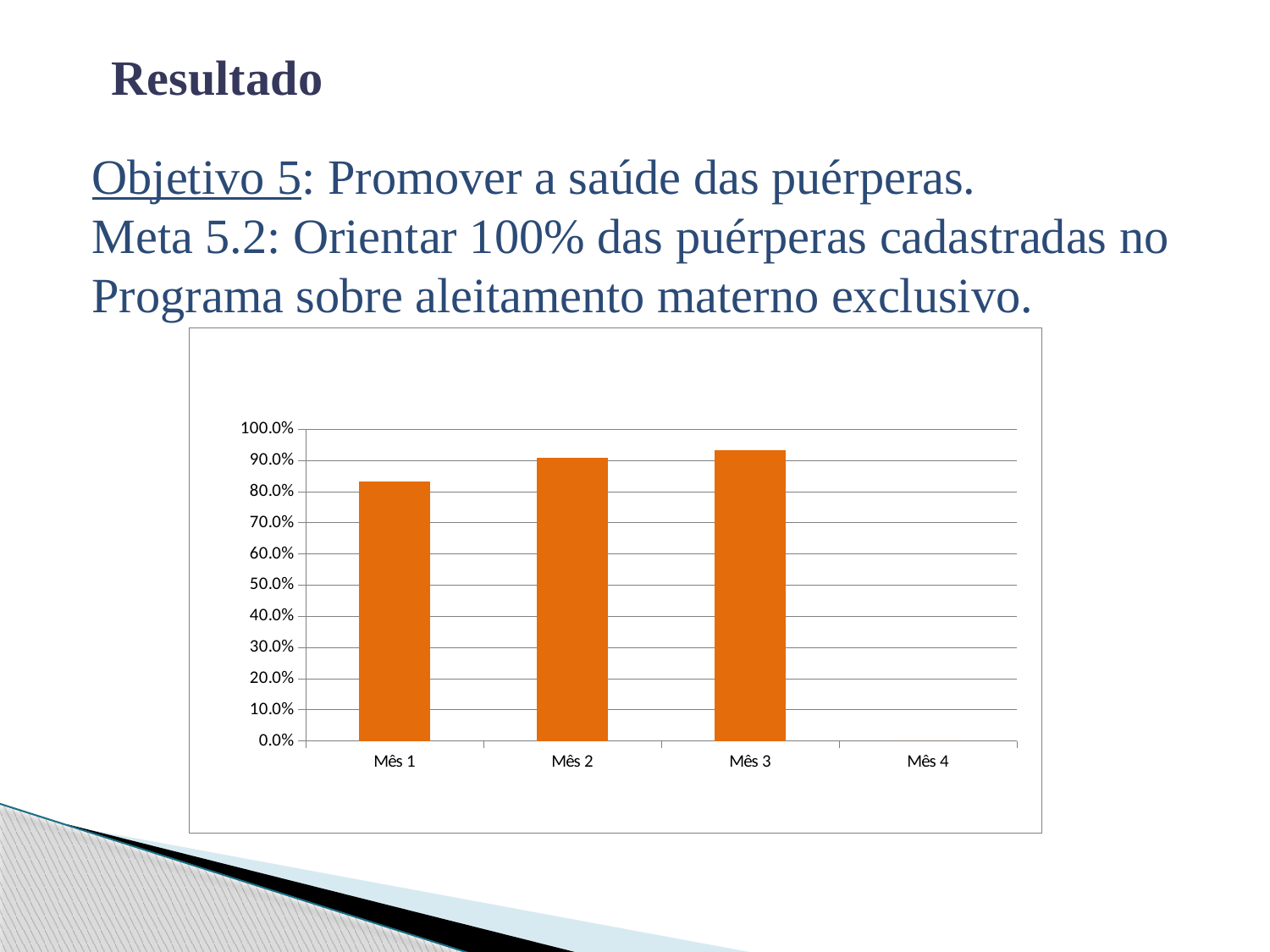
Among the months with a bar shown, which has the lowest value? Mês 1 Do the values rise or fall from Mês 1 to Mês 3? rise What kind of chart is shown on the slide? bar chart Is the value for Mês 1 greater or less than 80.0%? greater Which month on the x axis has no bar shown? Mês 4 Is the value for Mês 3 greater or less than 90.0%? greater Is the value for Mês 2 greater or less than 80.0%? greater How many categories are shown on the x axis of the chart? 4 Which is larger, the value for Mês 1 or the value for Mês 2? Mês 2 Which is larger, the value for Mês 1 or the value for Mês 3? Mês 3